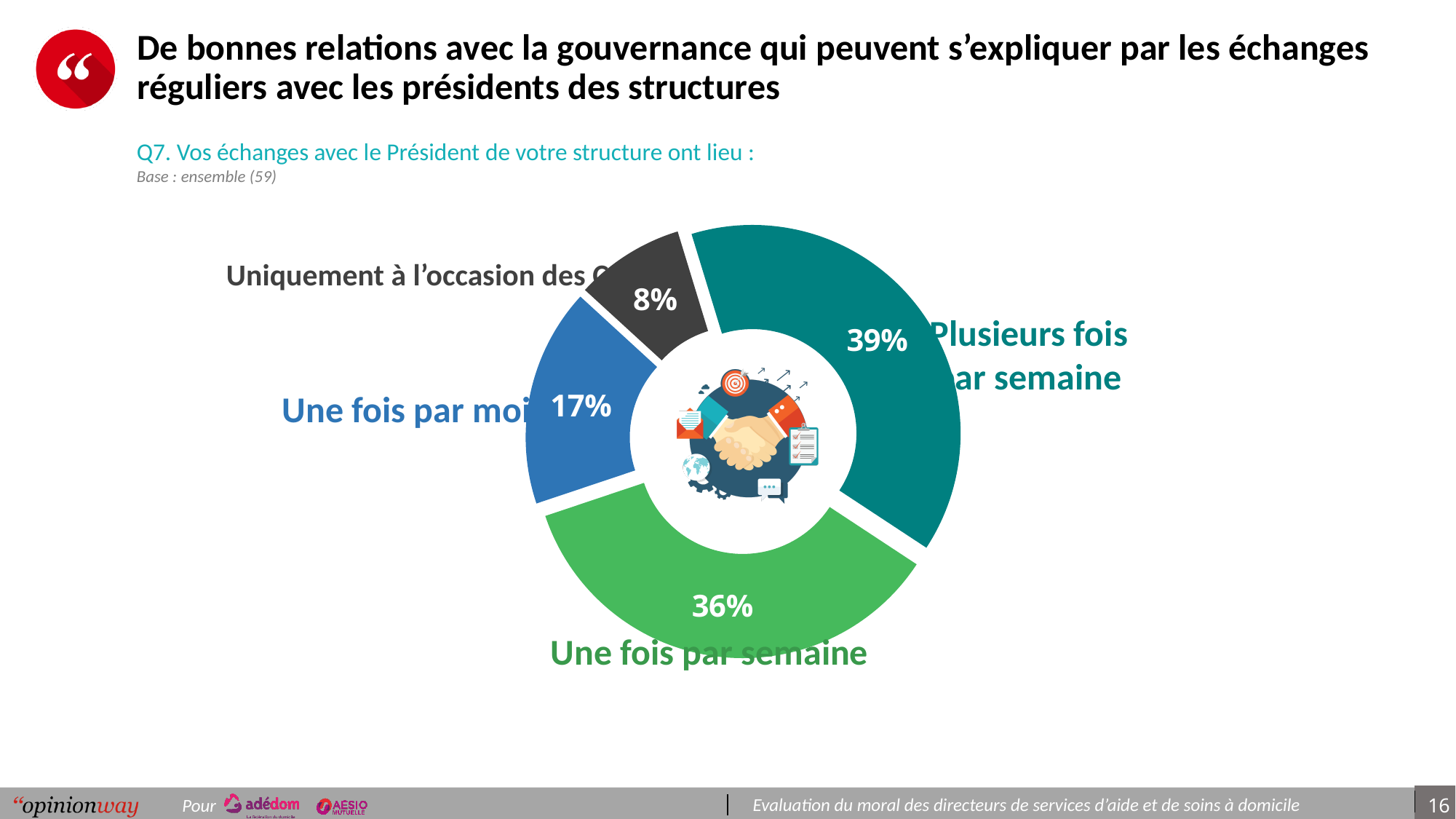
What is the difference in percentage points between 'Une fois par semaine' and 'Une fois par mois'? 19 percentage points What is the base (number of respondents) indicated for this question? 59 What is the smallest percentage shown on the chart? 8% What kind of chart is shown on the slide? Pie (donut) chart Which category has the largest share of the chart? Plusieurs fois par semaine Which is larger: the share for 'Une fois par semaine' or for 'Une fois par mois'? Une fois par semaine What percentage of respondents say their exchanges with the President take place 'Plusieurs fois par semaine'? 39% How many slices does the chart have? 4 What percentage is shown for 'Une fois par semaine'? 36% What percentage is shown for 'Une fois par mois'? 17% What percentage is shown on the dark grey slice of the chart? 8% What is the difference in percentage points between 'Plusieurs fois par semaine' and 'Une fois par semaine'? 3 percentage points